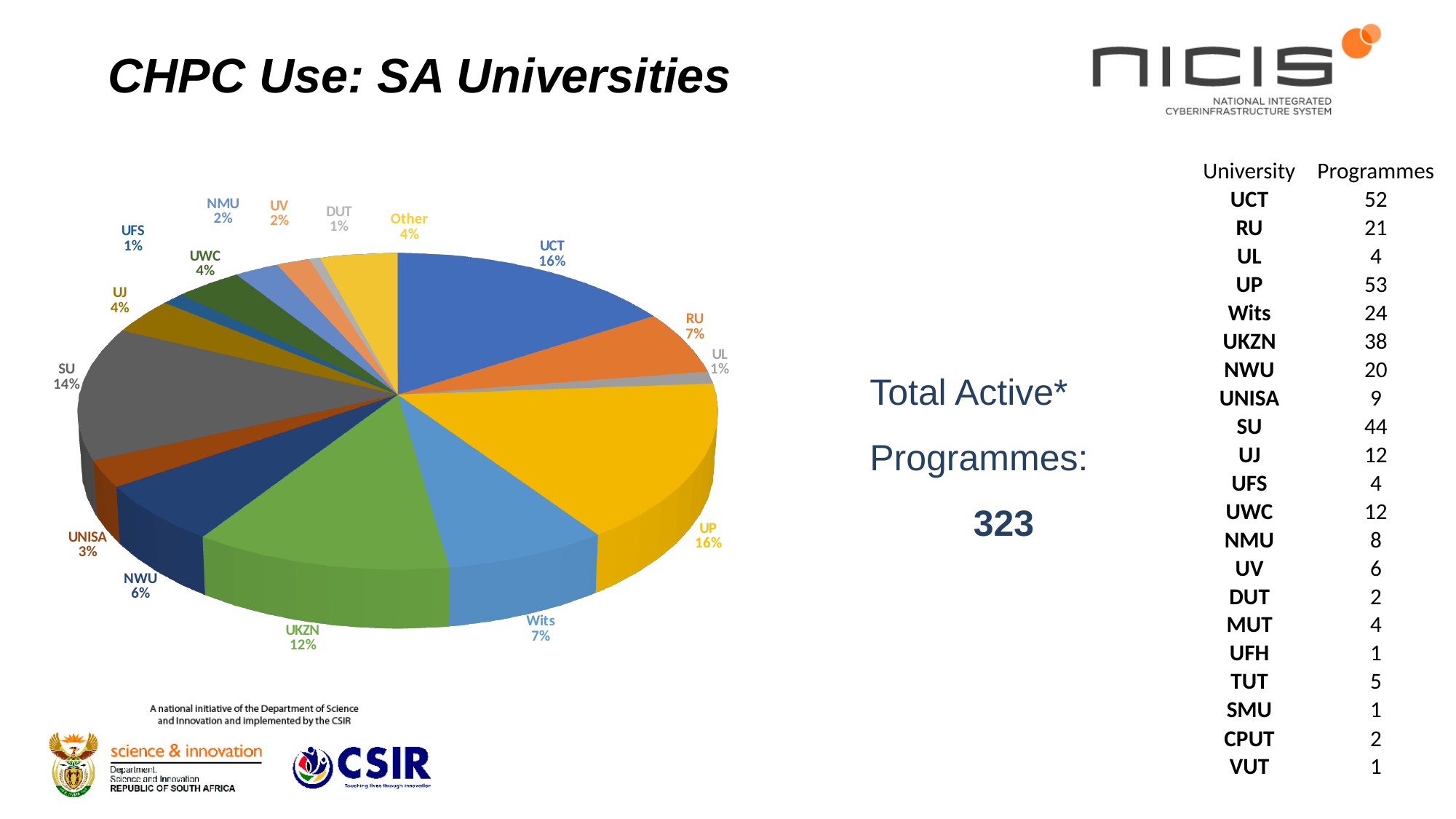
How many slices does the pie chart have? 16 What percentage is shown for SU in the pie chart? 14% What percentage is shown for NWU in the pie chart? 6% What is the difference in percentage points between the UCT and RU slices? 9 percentage points What percentage is shown for UNISA in the pie chart? 3% What percentage is shown for the 'Other' slice in the pie chart? 4% What kind of chart is shown on the slide? Pie chart What share of the pie chart does UCT account for? 16% Which slice is larger in the pie chart, SU or UKZN? SU Which slice is larger in the pie chart, RU or NWU? RU What percentage is shown for UKZN in the pie chart? 12% What is the difference in percentage points between the SU and UKZN slices? 2 percentage points